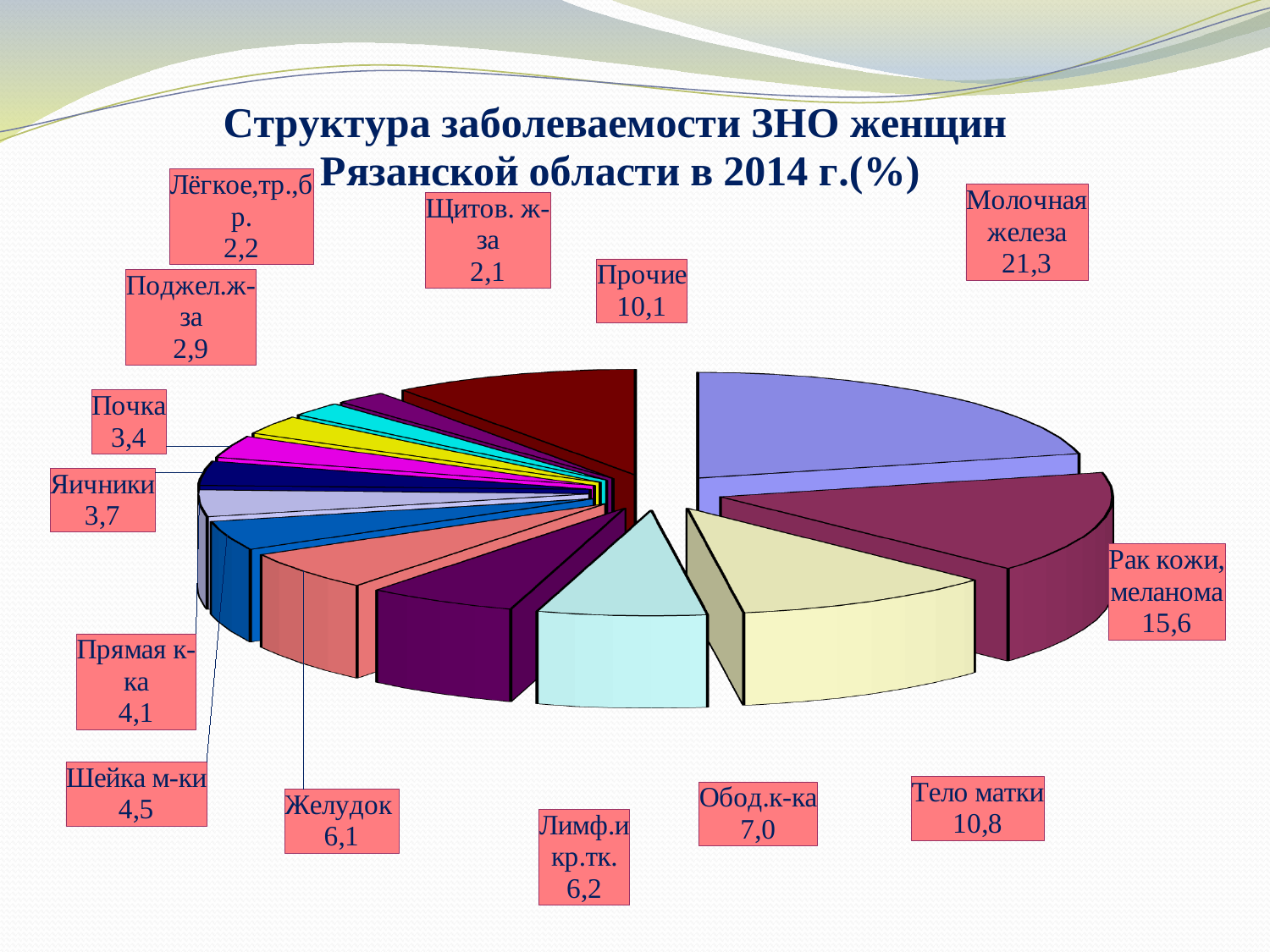
Which category has the smallest share of the pie? Щитов. ж-за What is the value for Шейка м-ки? 4,5 How many categories are shown in the pie chart? 14 What kind of chart is shown on the slide? pie chart What is the difference between the values for Молочная железа and Рак кожи, меланома? 5,7 What is the value for Рак кожи, меланома? 15,6 What is the value for Обод.к-ка? 7,0 Which category has the largest share of the pie? Молочная железа What is the value for Тело матки? 10,8 Which is larger, the value for Желудок or the value for Лимф.и кр.тк.? Лимф.и кр.тк. What year does the chart title refer to? 2014 What is the value for Молочная железа? 21,3